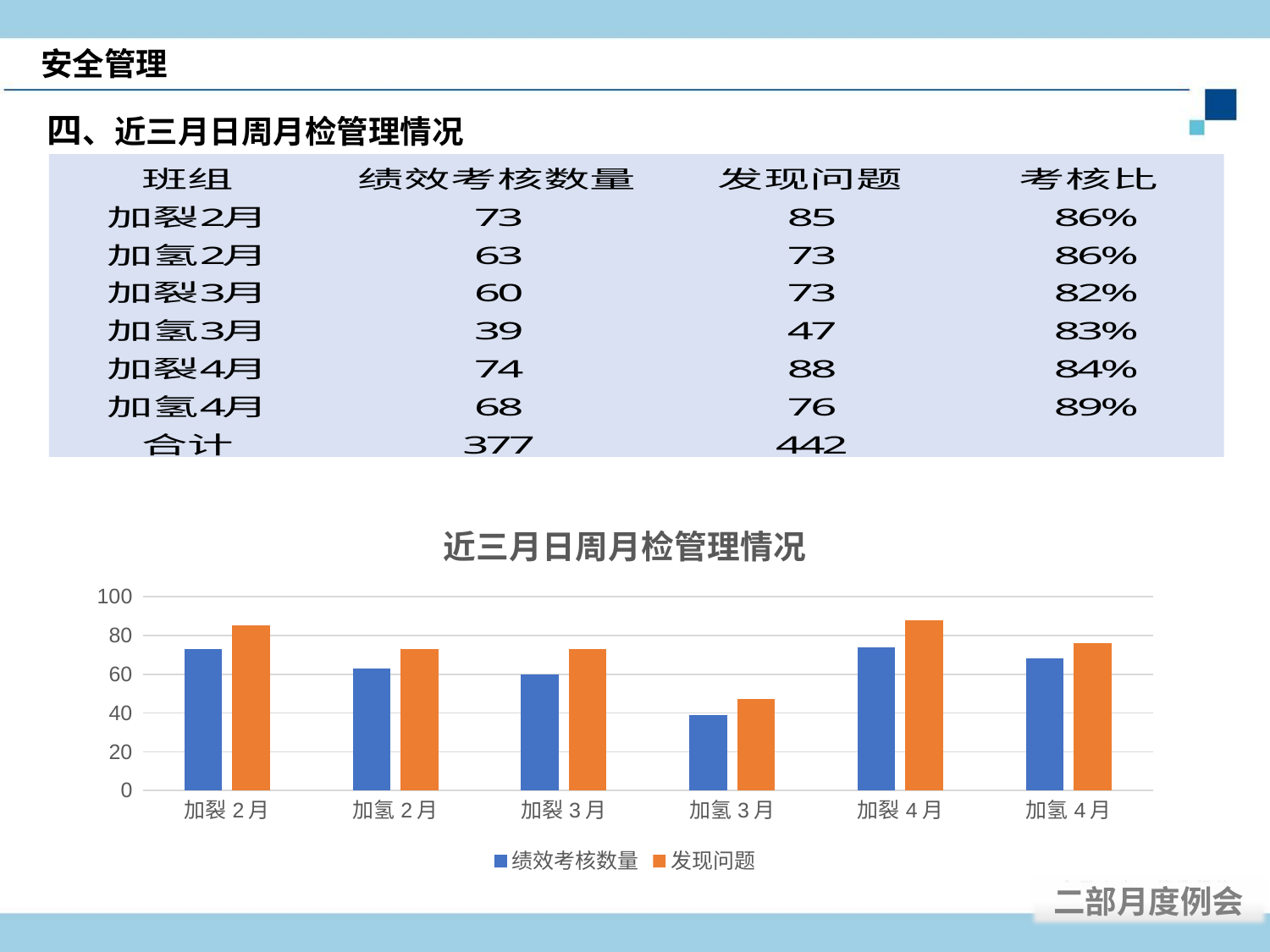
Which category has the lowest 绩效考核数量 value in the chart? 加氢3月 Is the 发现问题 value for 加裂4月 greater or less than 80? greater What is the title of the chart? 近三月日周月检管理情况 Which category has the highest 发现问题 value in the chart? 加裂4月 What is the 绩效考核数量 value for 加氢3月? 39 What is the difference between 发现问题 and 绩效考核数量 for 加裂2月? 12 What is the 发现问题 value for 加裂4月? 88 How many series does the chart legend list? 2 Which is larger, the 绩效考核数量 for 加裂4月 or for 加氢4月? 加裂4月 How many categories are shown on the x axis of the chart? 6 Is the 绩效考核数量 value for 加裂2月 greater or less than 80? less What kind of chart is shown on the slide? bar chart